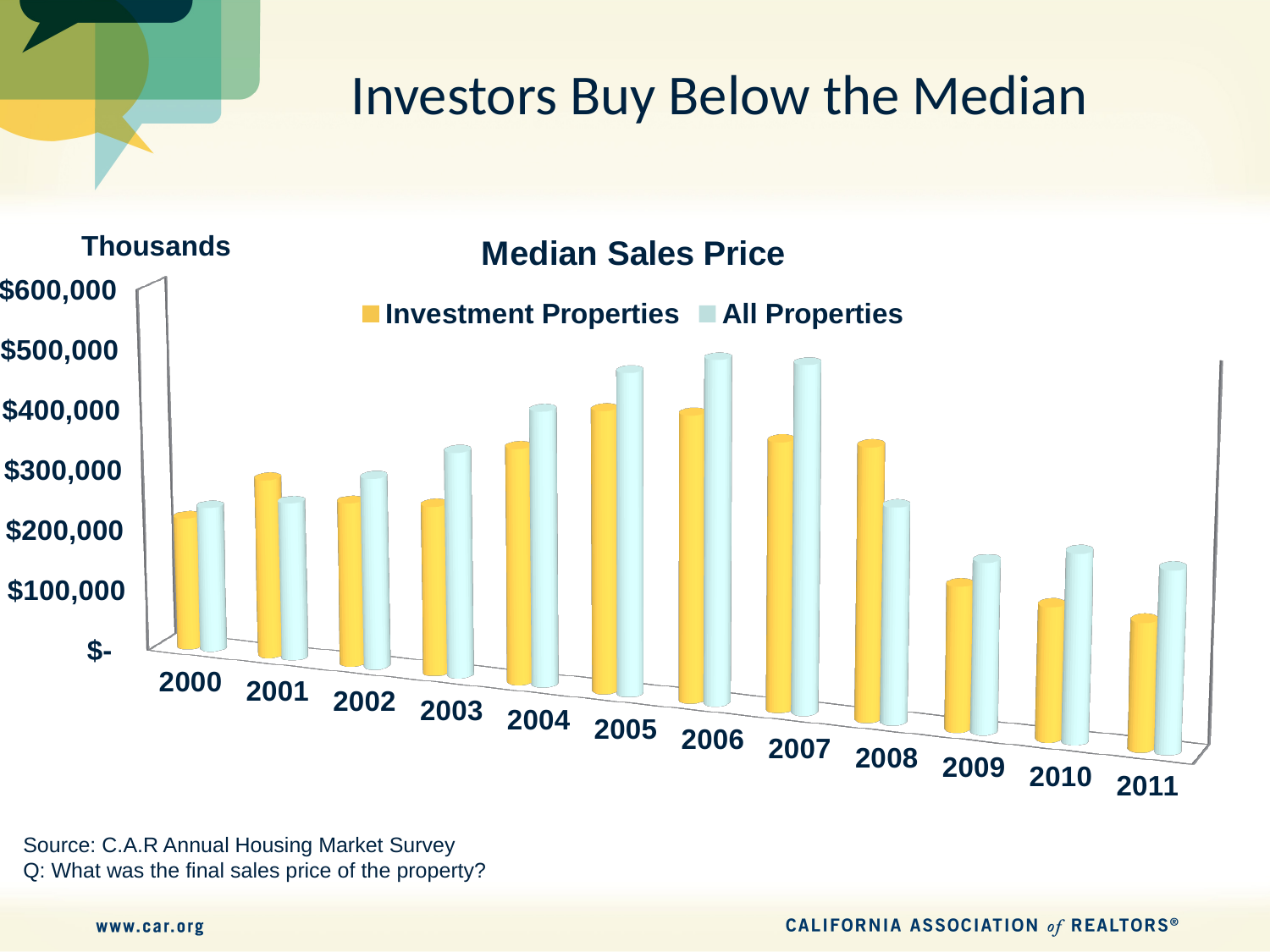
How many series does the legend list? 2 Is the value for Investment Properties in 2011 greater or less than $100,000? greater Which year has the lowest value for Investment Properties? 2011 Is the value for All Properties in 2006 greater or less than $400,000? greater Is the value for Investment Properties in 2005 greater or less than $300,000? greater Which series is shown in yellow? Investment Properties Which year has the lowest value for All Properties? 2000 How many years are shown on the x axis? 12 In 2008, which is larger: Investment Properties or All Properties? Investment Properties What is the title of the chart? Median Sales Price Do the Investment Properties values rise or fall from 2008 to 2011? Fall What kind of chart is shown on the slide? Bar chart